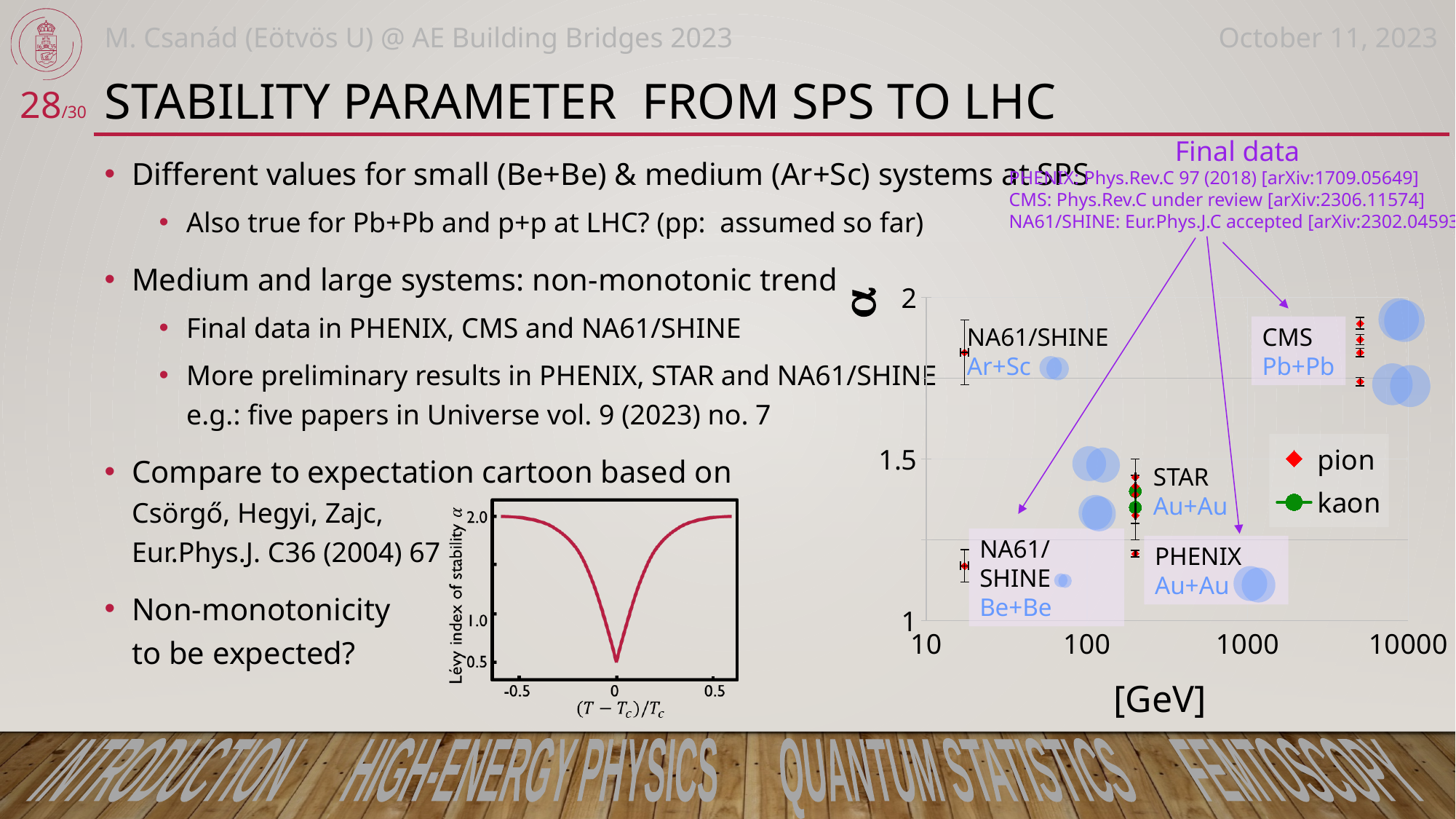
In the chart on the right (α versus energy in GeV), is the value for NA61/SHINE Ar+Sc greater or less than 1.5? greater In the small cartoon plot at the bottom left, does the curve rise or fall as (T−Tc)/Tc goes from −0.5 to 0? fall In the chart on the right (α versus energy in GeV), which has the larger α: NA61/SHINE Ar+Sc or NA61/SHINE Be+Be? NA61/SHINE Ar+Sc In the chart on the right (α versus energy in GeV), what unit is shown on the x axis? [GeV] In the chart on the right (α versus energy in GeV), how many labelled experiment/collision-system groups are shown? 5 In the chart on the right (α versus energy in GeV), is the value for PHENIX Au+Au greater or less than 1.5? less What kind of chart is the small cartoon plot at the bottom left (Lévy index of stability α versus (T−Tc)/Tc)? line chart In the chart on the right (α versus energy in GeV), which has the larger α: CMS Pb+Pb or PHENIX Au+Au? CMS Pb+Pb In the chart on the right (α versus energy in GeV), how many series does the legend list? 2 In the chart on the right (α versus energy in GeV), what are the two legend entries? pion and kaon In the chart on the right (α versus energy in GeV), is the value for NA61/SHINE Be+Be greater or less than 1.5? less